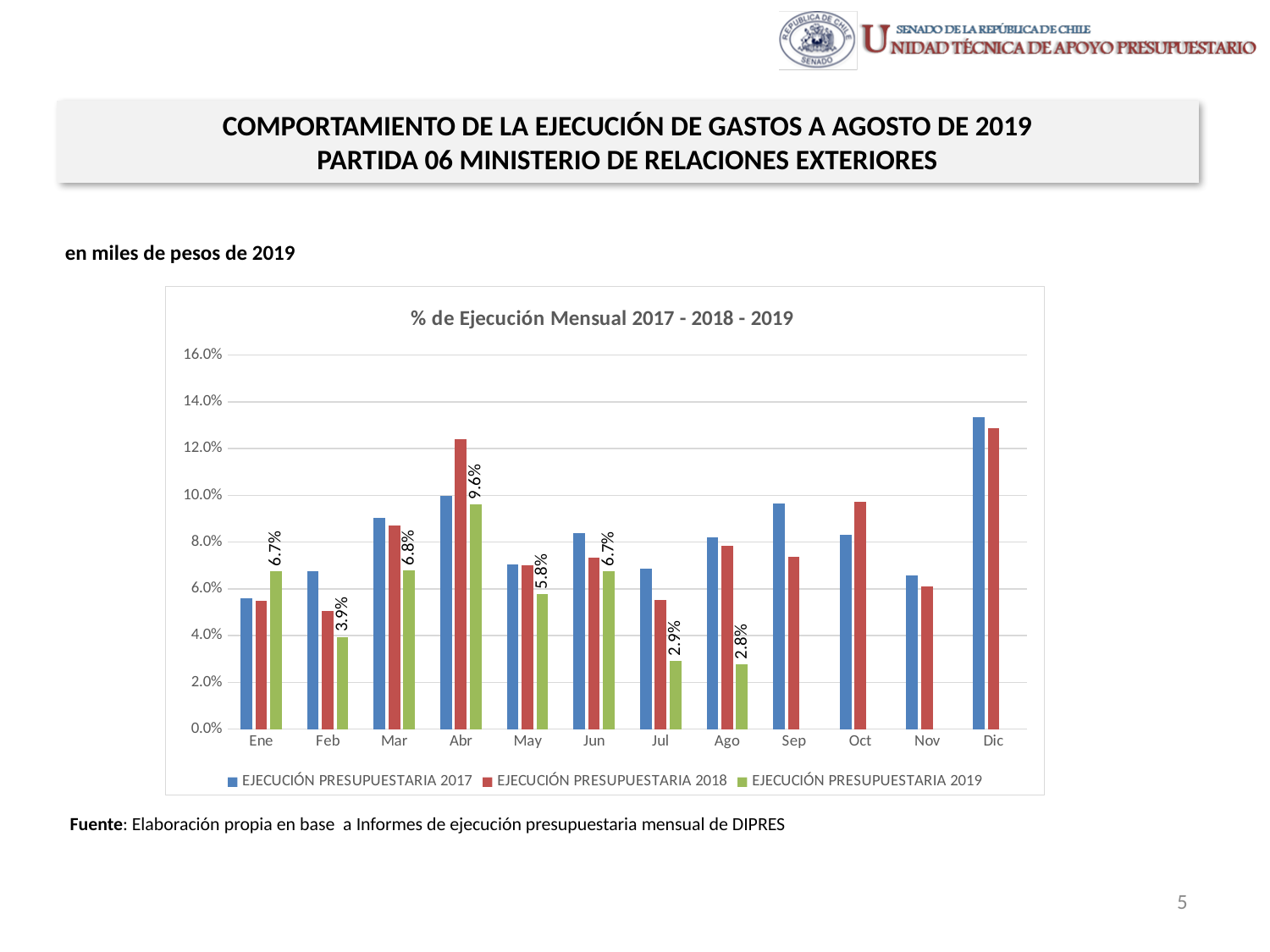
What is the value for EJECUCIÓN PRESUPUESTARIA 2019 in Feb? 3.9% How many series does the legend list? 3 What kind of chart is shown on the slide? Bar chart Is the value for EJECUCIÓN PRESUPUESTARIA 2017 in Dic greater or less than 12.0%? greater In which month is the EJECUCIÓN PRESUPUESTARIA 2019 value lowest? Ago What is the value for EJECUCIÓN PRESUPUESTARIA 2019 in Ago? 2.8% What is the difference between the EJECUCIÓN PRESUPUESTARIA 2019 values for Abr and Jul? 6.7% Which is larger, the EJECUCIÓN PRESUPUESTARIA 2019 value for Mar or for May? Mar How many months are shown on the x axis? 12 What is the value for EJECUCIÓN PRESUPUESTARIA 2019 in Abr? 9.6% Is the value for EJECUCIÓN PRESUPUESTARIA 2018 in Jul greater or less than 6.0%? less In which month is the EJECUCIÓN PRESUPUESTARIA 2019 value highest? Abr